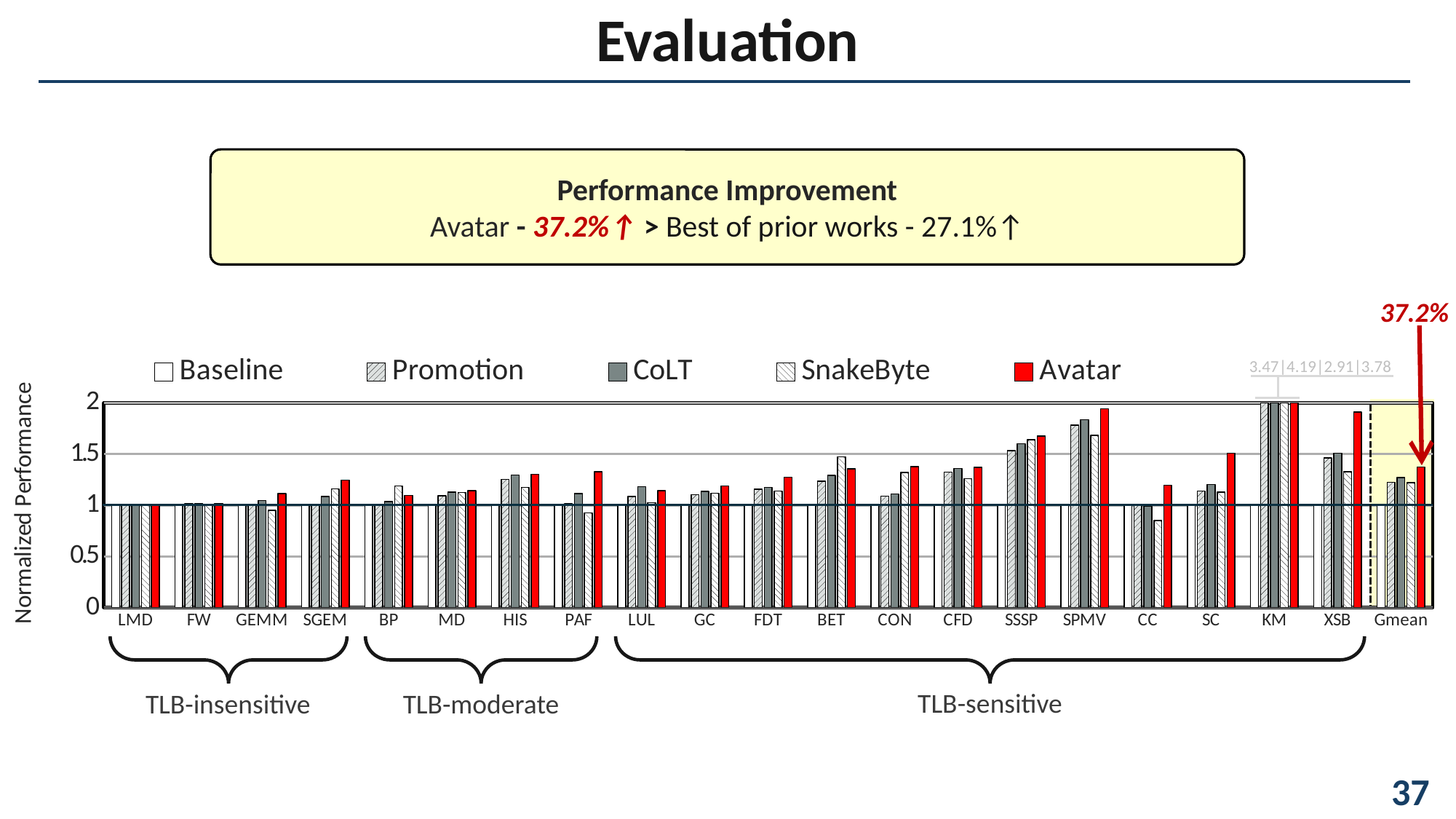
What is the CoLT value for KM? 4.19 What is the SnakeByte value for KM? 2.91 How many categories are shown along the x axis? 21 What kind of chart is shown on the slide? bar chart For PAF, which is larger, the Avatar value or the SnakeByte value? Avatar What is the Avatar value for KM? 3.78 Is the Avatar value for SPMV greater or less than 1.5? greater For KM, what is the difference between the CoLT value and the Avatar value? 0.41 Is the SnakeByte value for CC greater or less than 1? less For KM, which series has the highest value? CoLT How many series does the legend list? 5 What is the title of the y axis? Normalized Performance